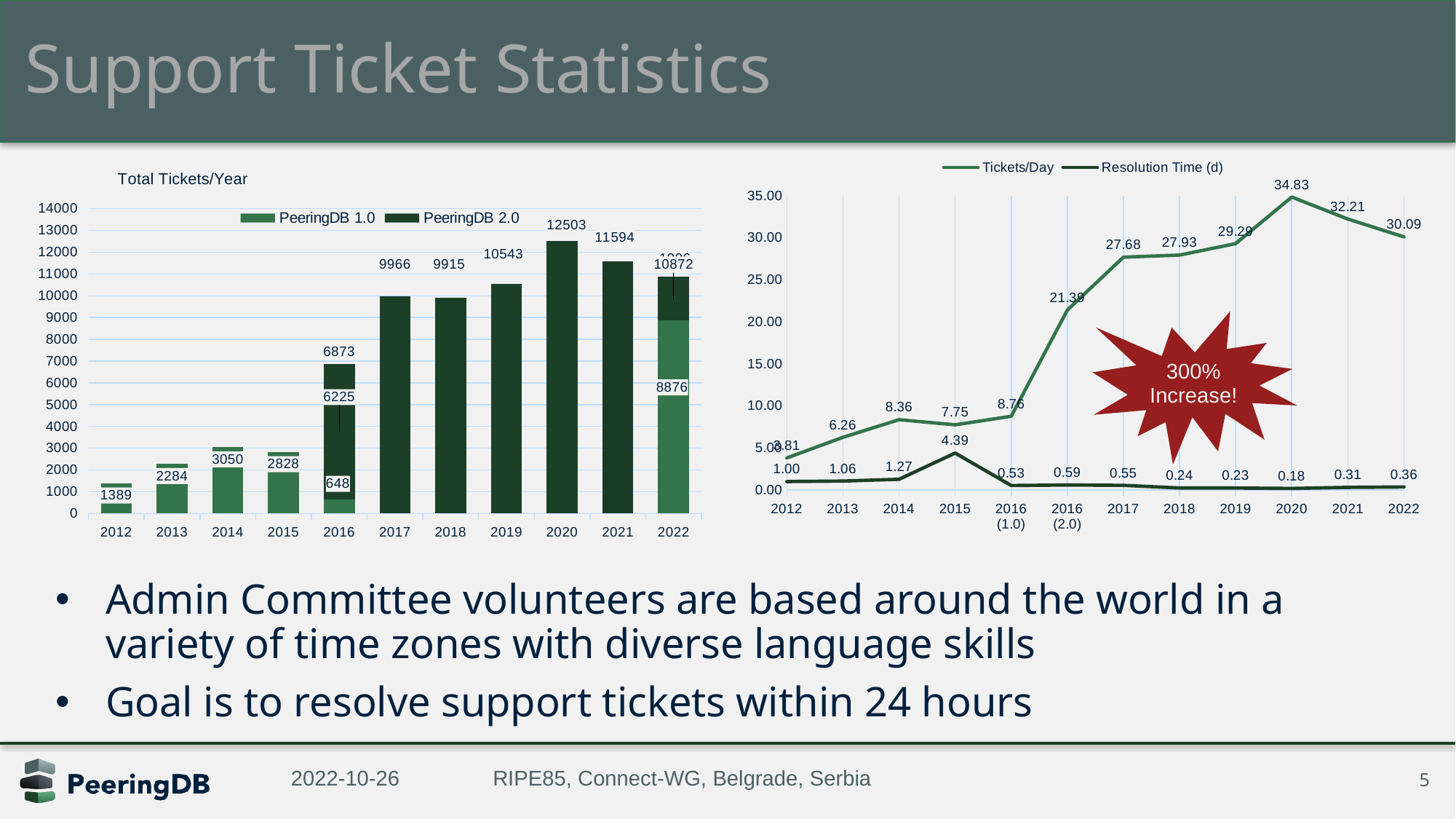
In the right-hand line chart, which year has the lowest Resolution Time (d)? 2020 In the Total Tickets/Year chart, what is the total number of tickets for 2020? 12503 In the Total Tickets/Year chart, what is the difference between the total tickets in 2020 and 2021? 909 In the right-hand line chart, what is the Tickets/Day value for 2020? 34.83 In the right-hand line chart, which is larger, the Tickets/Day value for 2021 or for 2022? 2021 In the Total Tickets/Year chart, which year has the highest total tickets? 2020 In the Total Tickets/Year chart, what is the PeeringDB 1.0 value for 2022? 8876 How many series does the legend of the Total Tickets/Year chart list? 2 In the right-hand line chart, which year has the highest Resolution Time (d)? 2015 What kind of chart is the Total Tickets/Year chart? Bar chart In the Total Tickets/Year chart, which year has the lowest total tickets? 2012 In the Total Tickets/Year chart, what is the PeeringDB 1.0 value for 2016? 648